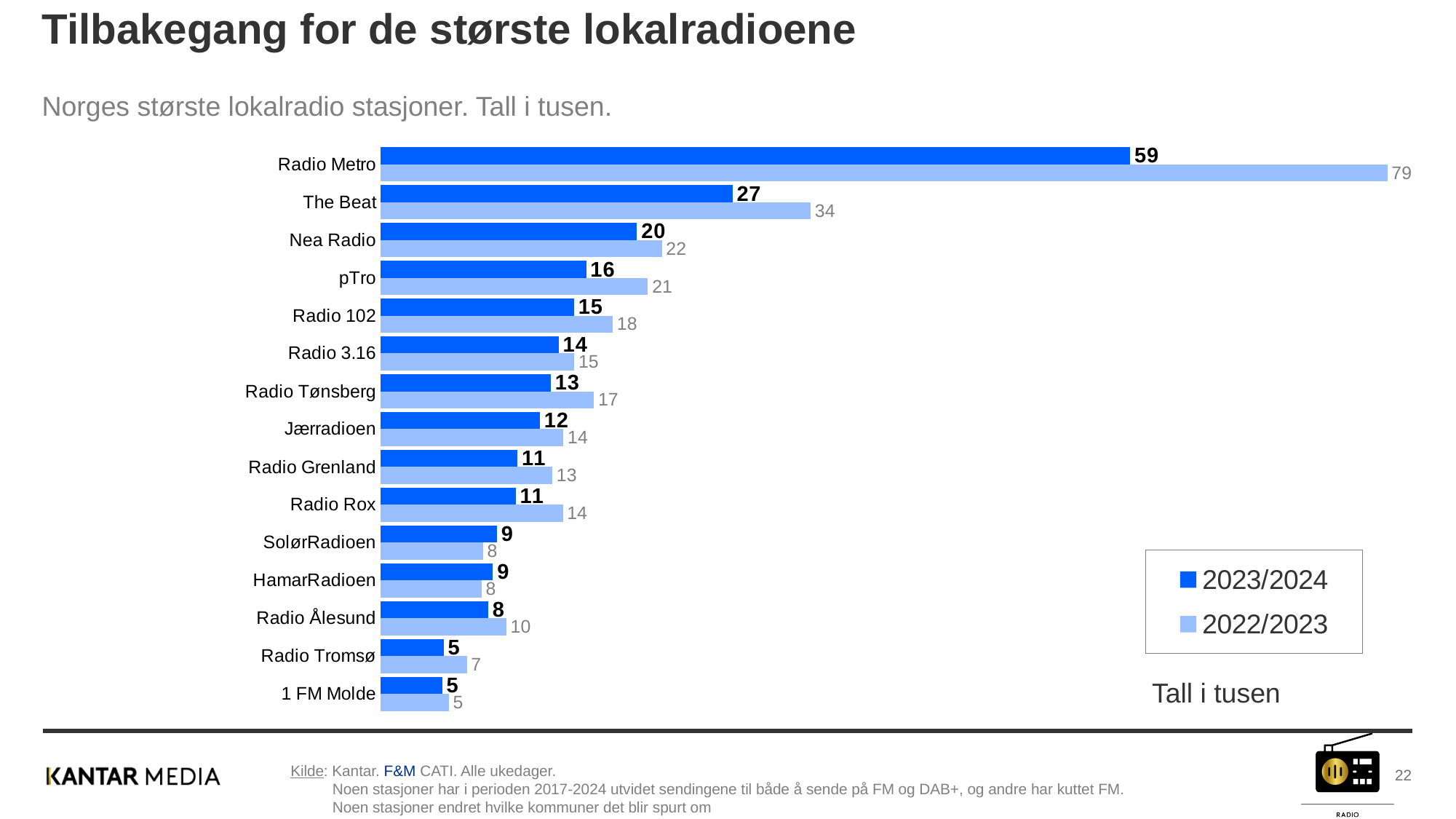
How many series does the legend list? 2 What is the title of the slide? Tilbakegang for de største lokalradioene How many stations are shown in the chart? 15 What kind of chart is shown on the slide? Bar chart What is the difference between the 2022/2023 and 2023/2024 values for The Beat? 7 What is the 2022/2023 value for The Beat? 34 Which station has the lowest 2022/2023 value? 1 FM Molde Which is larger for SolørRadioen: the 2023/2024 value or the 2022/2023 value? 2023/2024 What is the 2023/2024 value for Radio Tønsberg? 13 What is the difference between the 2022/2023 and 2023/2024 values for Radio Metro? 20 Which station has the highest 2022/2023 value? Radio Metro What is the 2023/2024 value for Radio Metro? 59